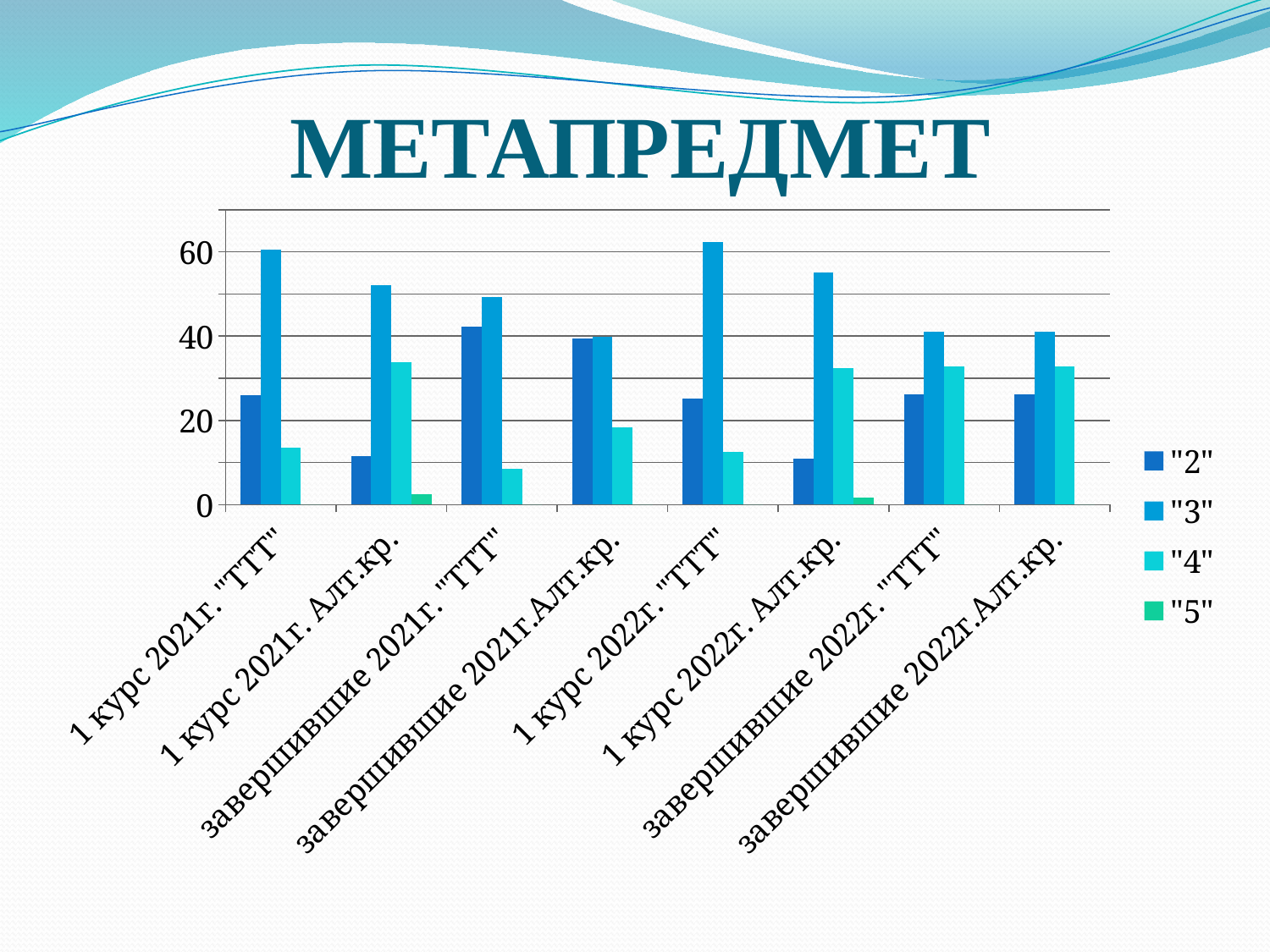
Which category has the lowest value for series "4"? завершившие 2021г. "ТТТ" What is the title of the chart? МЕТАПРЕДМЕТ For 1 курс 2021г. "ТТТ", which series has the larger value, "2" or "3"? "3" What kind of chart is shown on the slide? bar chart Is the value of series "2" for 1 курс 2021г. "ТТТ" greater or less than 20? greater Is the value of series "3" for 1 курс 2022г. Алт.кр. greater or less than 40? greater Is the value of series "4" for 1 курс 2021г. Алт.кр. greater or less than 40? less How many series does the legend list? 4 How many categories are shown on the x axis? 8 Which series is shown in green in the legend? "5"